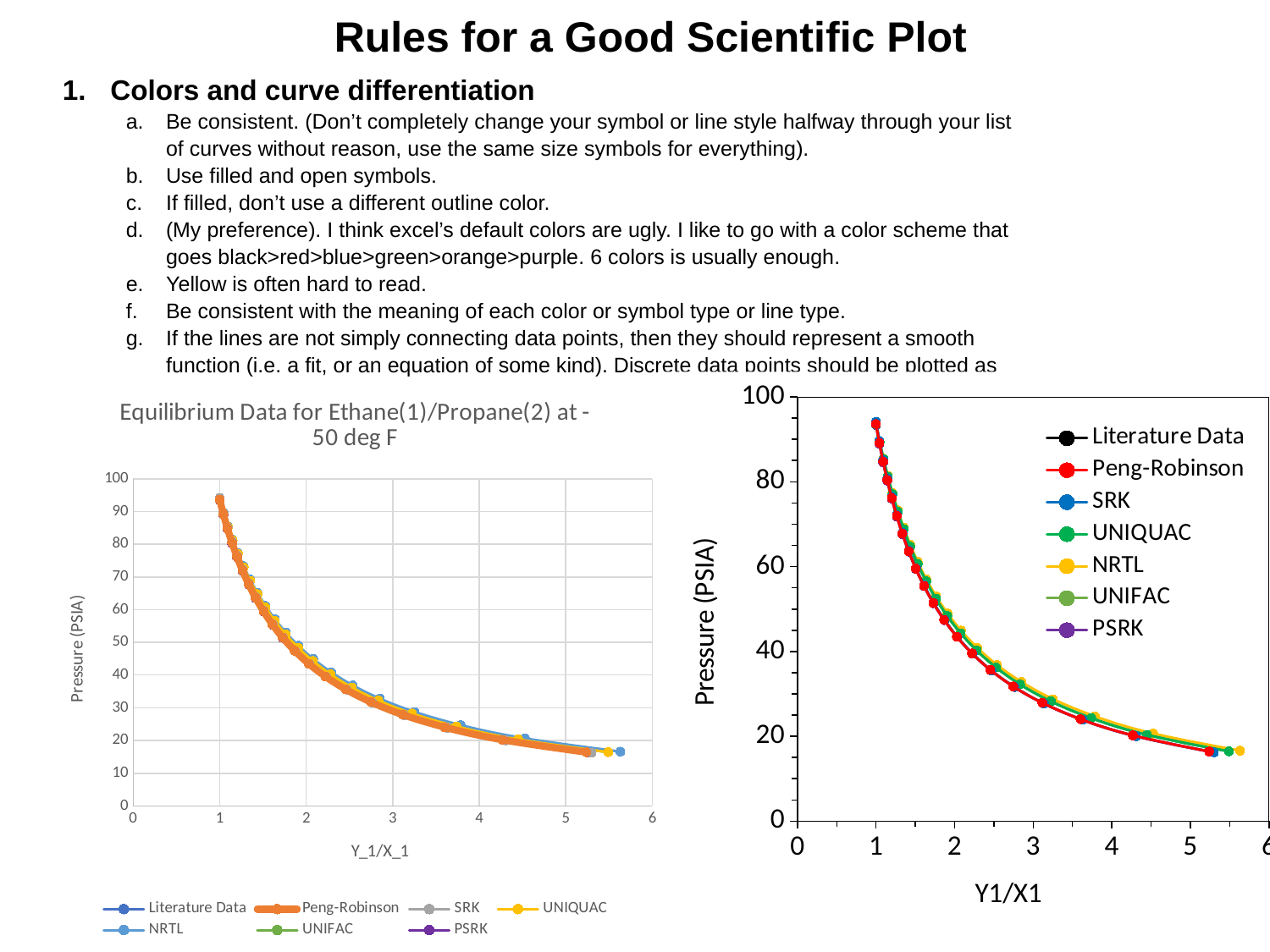
What kind of chart is the right chart on the slide? Line chart In the right chart, what is the highest value shown on the y axis? 100 What is the label of the y axis on the right chart? Pressure (PSIA) In the right chart, is the pressure at Y1/X1 = 3 greater or less than 40? less How many series does the legend of the left chart list? 7 In the right chart, is the pressure at Y1/X1 = 1 greater or less than 80? greater In the left chart, does pressure rise or fall as Y_1/X_1 increases? Fall What is the title of the chart on the left side of the slide? Equilibrium Data for Ethane(1)/Propane(2) at -50 deg F How many series does the legend of the right chart list? 7 In the right chart, does pressure rise or fall as Y1/X1 increases? Fall In the right chart, is the pressure at Y1/X1 = 5 greater or less than 20? less